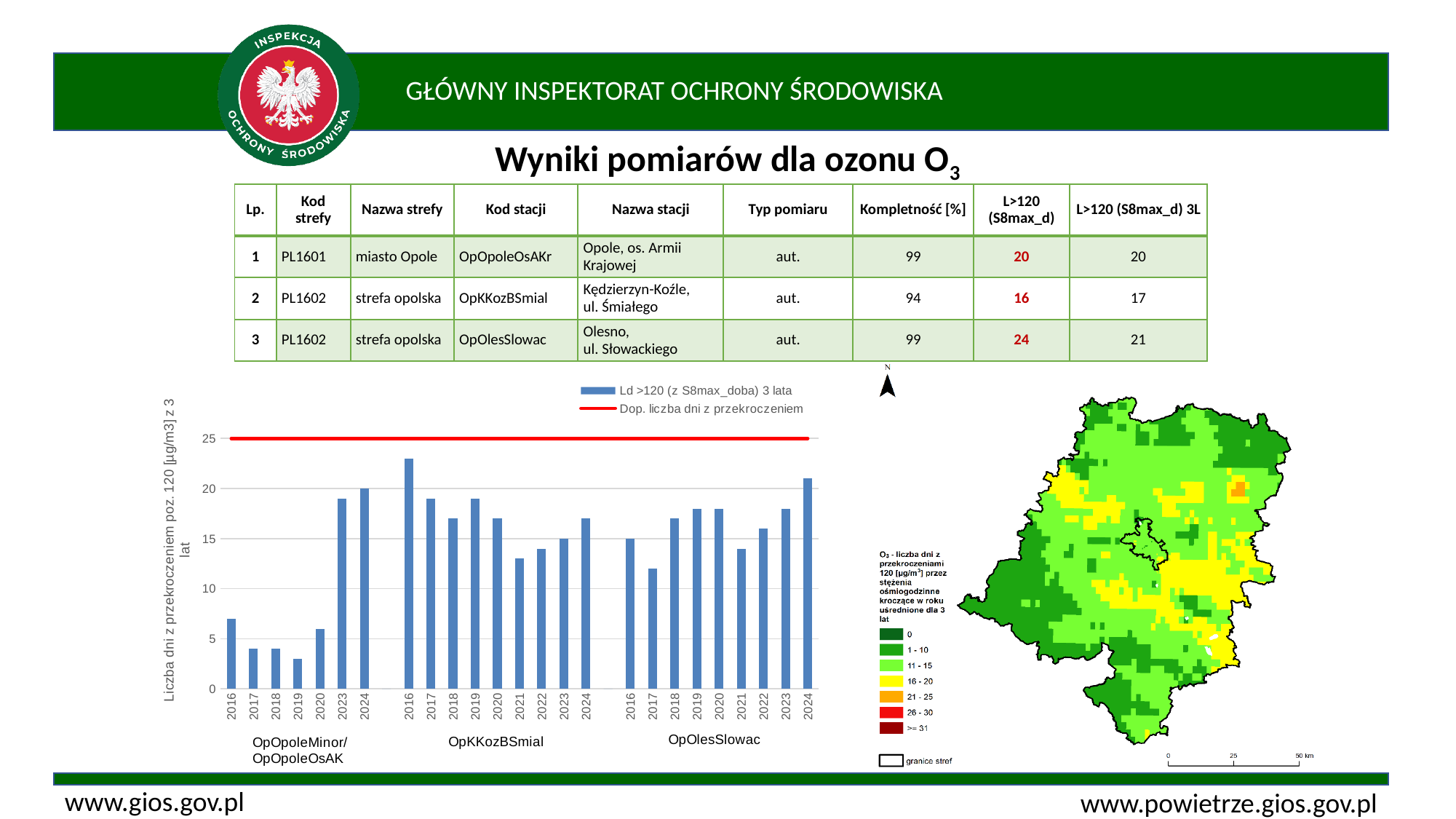
In the bar chart, which year has the lowest value for OpOpoleMinor/OpOpoleOsAK? 2019 What kind of chart is shown at the bottom left of the slide? bar chart In the bar chart, which year has the higher value for OpOlesSlowac: 2017 or 2024? 2024 In the bar chart, is the value for OpOpoleMinor/OpOpoleOsAK in 2019 greater or less than 5? less At what value on the y axis is the red horizontal line in the bar chart drawn? 25 How many station groups are shown along the x axis of the bar chart? 3 In the bar chart, is the value for OpKKozBSmial in 2016 greater or less than 20? greater How many bars are plotted for the OpOpoleMinor/OpOpoleOsAK group in the bar chart? 7 How many entries does the legend of the bar chart list? 2 In the bar chart, which year has the highest value for OpKKozBSmial? 2016 What does the legend of the bar chart call the red line? Dop. liczba dni z przekroczeniem In the bar chart, is the value for OpOlesSlowac in 2017 greater or less than 15? less